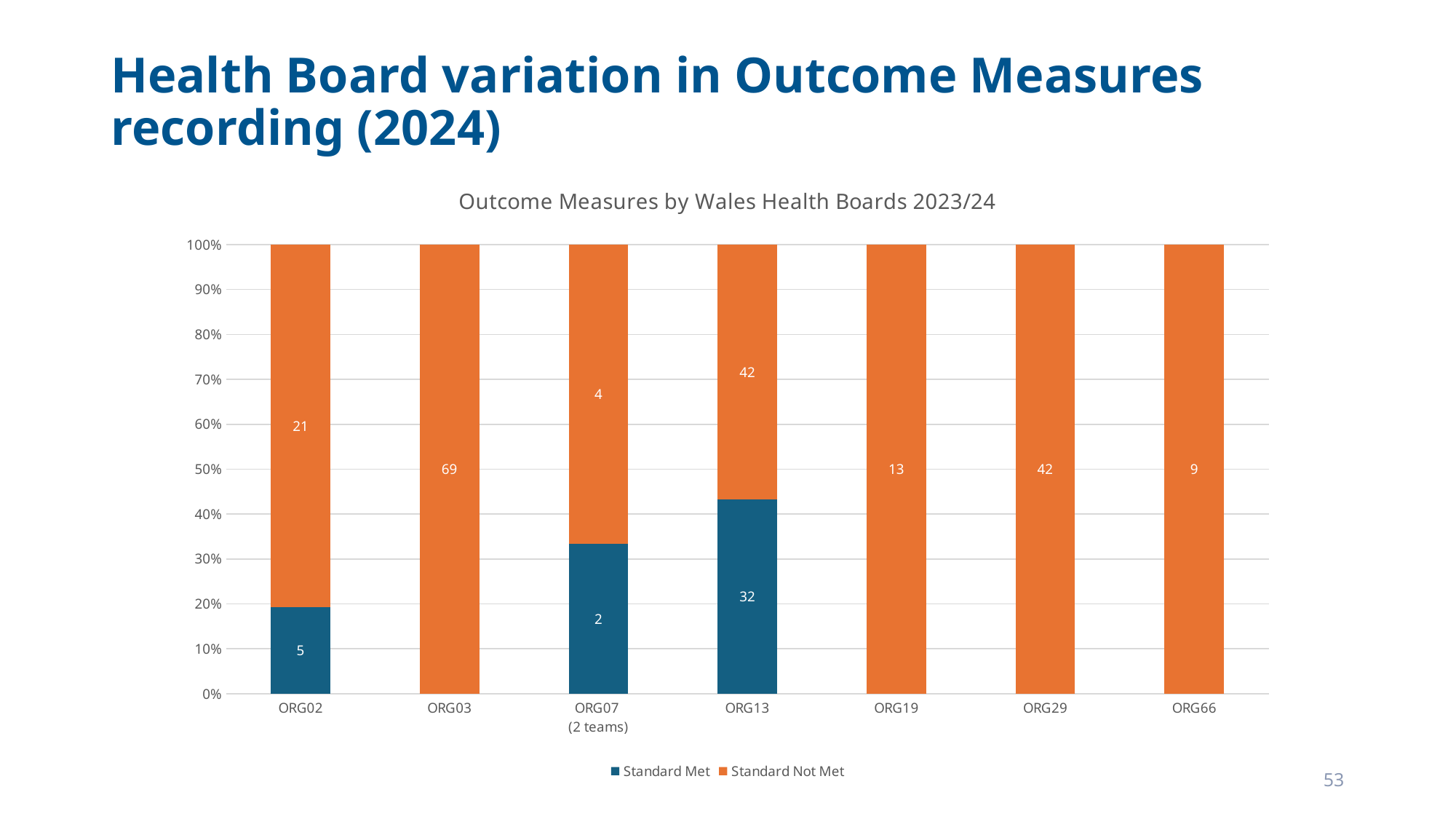
Is the Standard Met share for ORG13 greater or less than 40%? greater What is the Standard Not Met value for ORG03? 69 What is the difference between the Standard Not Met and Standard Met values for ORG02? 16 Which health board has the lowest Standard Not Met value? ORG07 (2 teams) Which health board has the highest Standard Not Met value? ORG03 What is the Standard Not Met value for ORG66? 9 What type of chart is shown on the slide? Stacked bar chart What is the total number of records (Standard Met plus Standard Not Met) for ORG13? 74 How many health boards (categories) are shown on the x axis? 7 What is the Standard Met value for ORG13? 32 What is the title of the chart? Outcome Measures by Wales Health Boards 2023/24 How many series does the legend list? 2